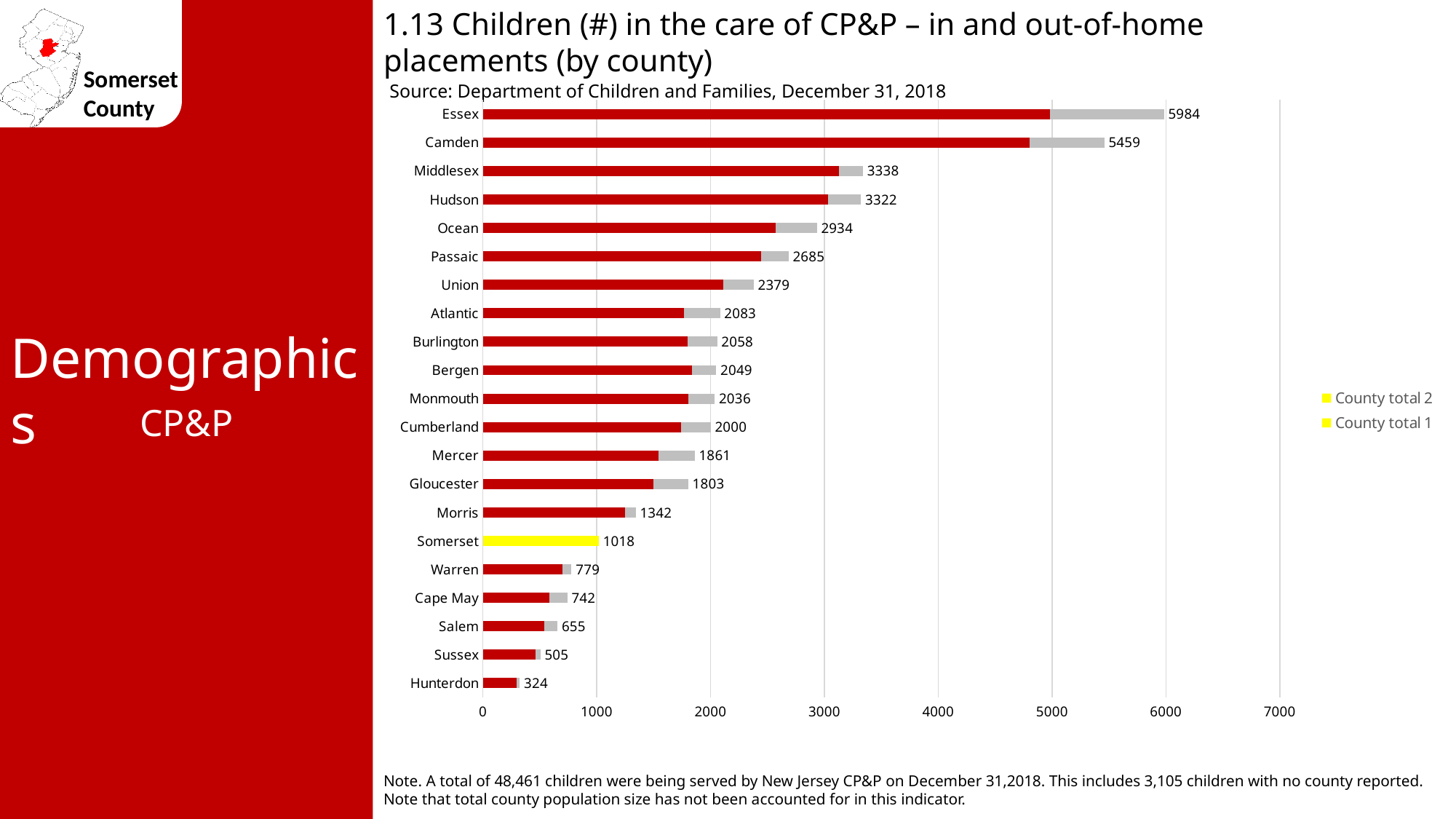
How many counties are shown on the chart? 21 What is the total number of children in the care of CP&P for Essex county? 5984 What kind of chart is shown on the slide? Bar chart Which county has the highest total number of children in the care of CP&P? Essex What is the total value shown for Somerset county? 1018 Which county has the lowest total number of children in the care of CP&P? Hunterdon Which county's bar is highlighted in yellow? Somerset Is the total for Passaic greater or less than 3000? less Which county has a larger total, Morris or Somerset? Morris How many entries does the legend list? 2 What is the total value shown for Hunterdon county? 324 What is the difference between the totals for Essex and Camden? 525